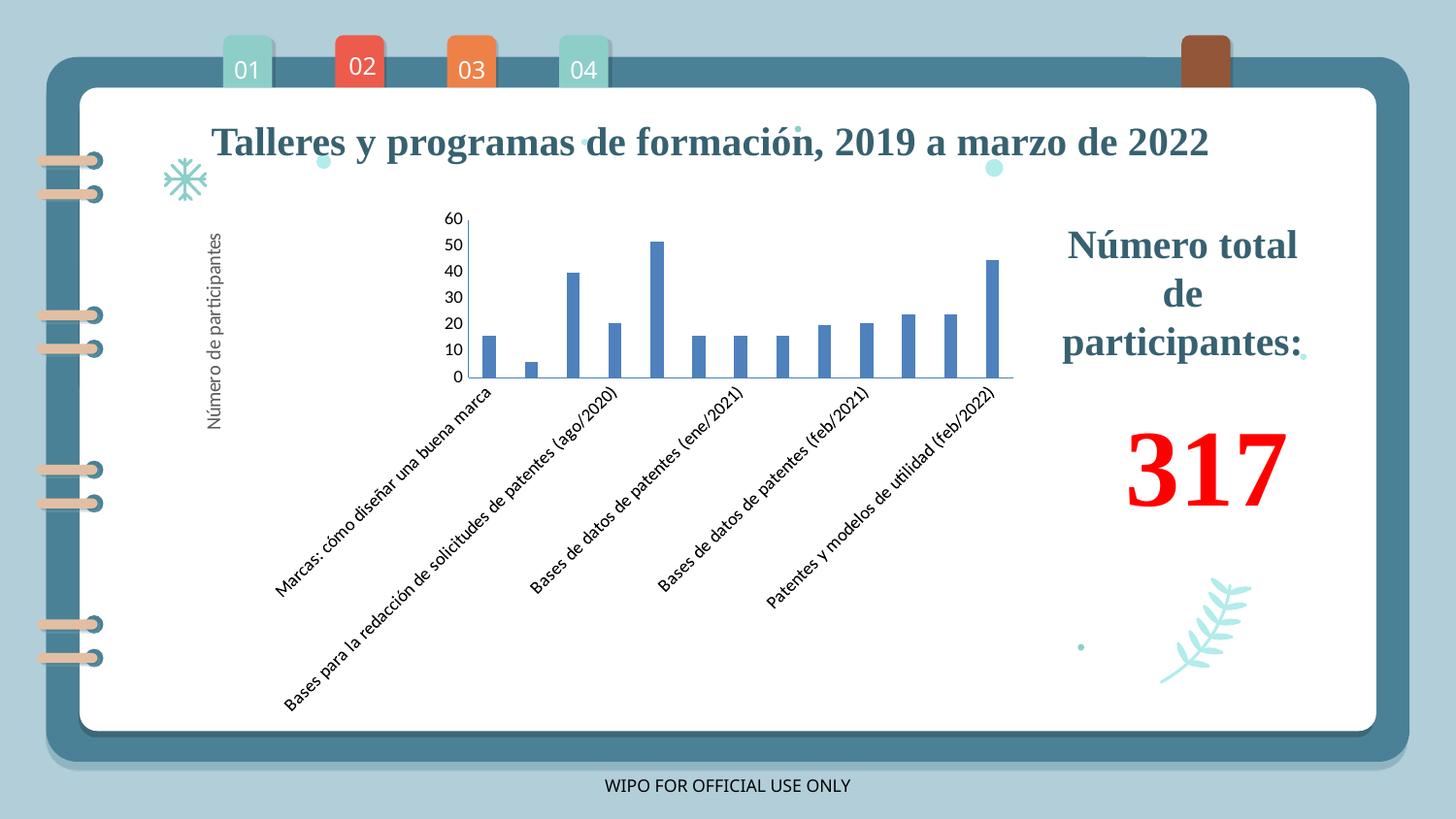
What kind of chart is shown on the slide? bar chart What is the maximum value shown on the vertical axis of the chart? 60 Is the value for 'Marcas: cómo diseñar una buena marca' greater or less than 20? less How many bars does the chart contain? 13 What is the title of the chart on the slide? Talleres y programas de formación, 2019 a marzo de 2022 What is the label of the vertical axis of the chart? Número de participantes Is the highest bar in the chart greater or less than 40? greater Is the value for 'Patentes y modelos de utilidad (feb/2022)' greater or less than 40? greater Which has more participants: 'Marcas: cómo diseñar una buena marca' or 'Patentes y modelos de utilidad (feb/2022)'? Patentes y modelos de utilidad (feb/2022)